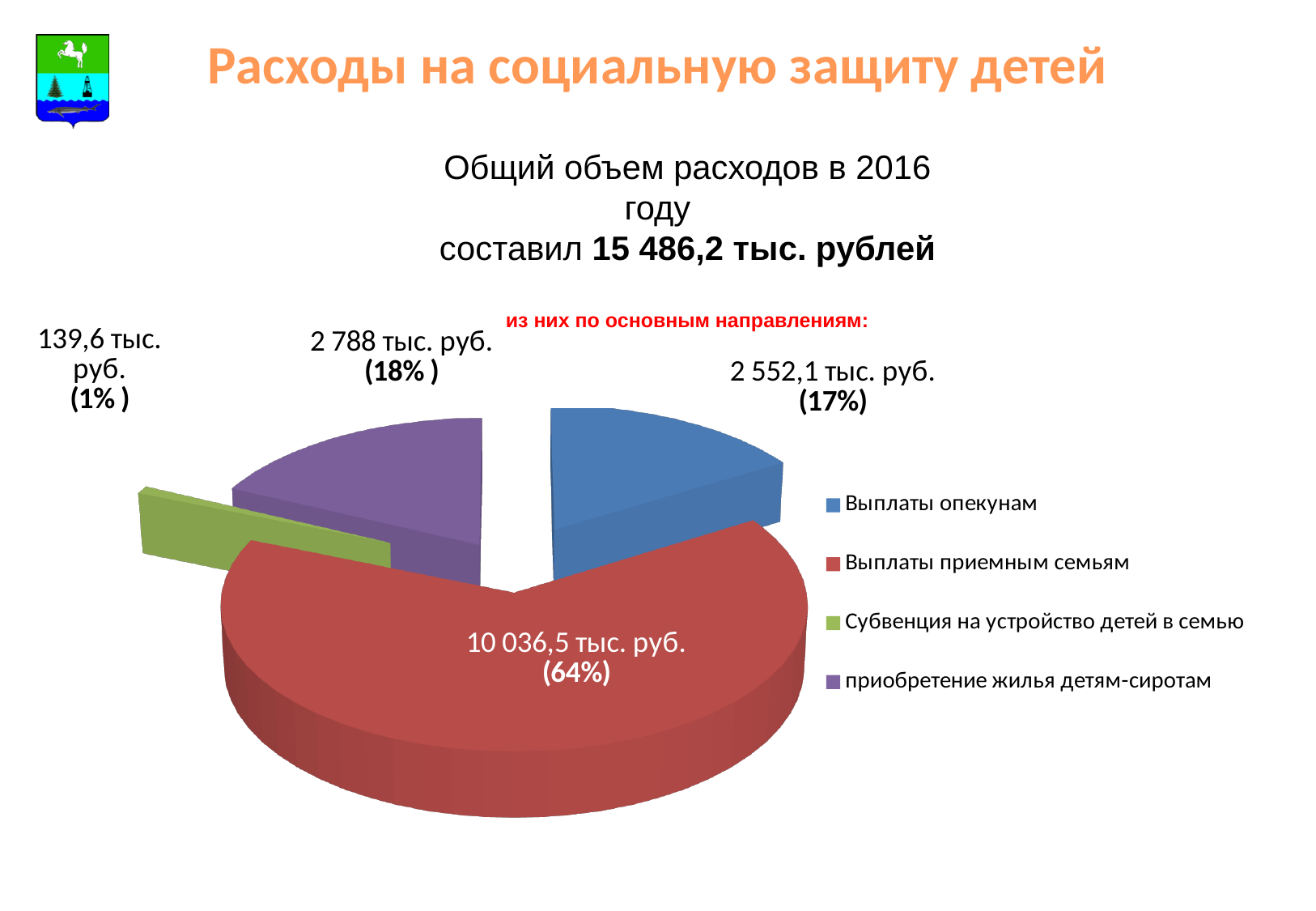
What kind of chart is shown on the slide? pie chart What is the value shown for 'приобретение жилья детям-сиротам'? 2 788 тыс. руб. What share of the pie does 'Выплаты приемным семьям' represent? 64% Which category has the smallest slice of the pie? Субвенция на устройство детей в семью What is the value shown for 'Выплаты приемным семьям'? 10 036,5 тыс. руб. How many entries does the legend of the pie chart list? 4 Which category has the largest slice of the pie? Выплаты приемным семьям What colour is the slice for 'Выплаты опекунам'? blue What is the value shown for 'Субвенция на устройство детей в семью'? 139,6 тыс. руб. What is the value shown for 'Выплаты опекунам'? 2 552,1 тыс. руб. What share of the pie does 'приобретение жилья детям-сиротам' represent? 18% How many slices does the pie chart have? 4